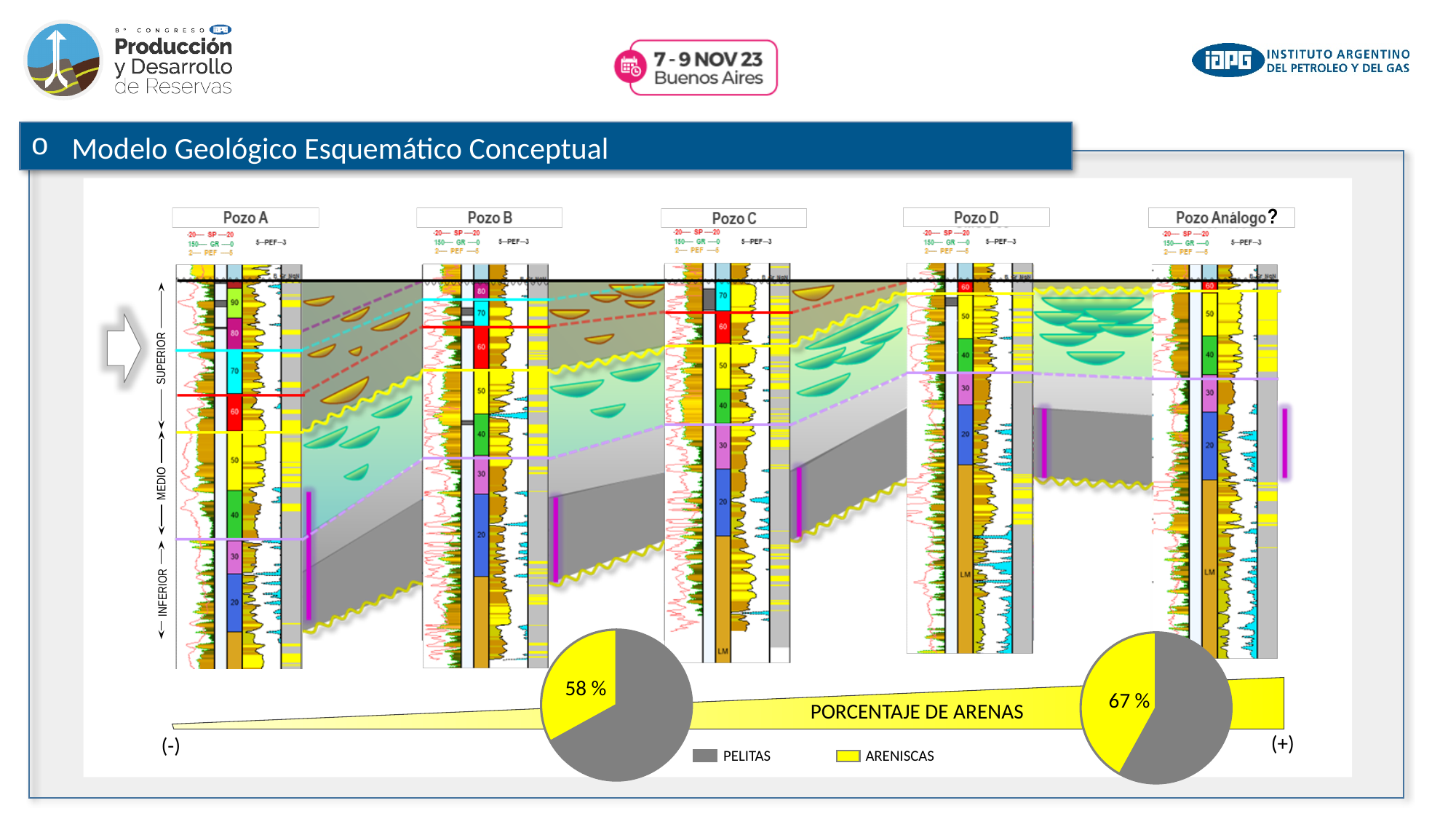
How many entries does the legend shared by the pie charts list? 2 What is the difference between the percentage labelled on the right pie chart and the one labelled on the left pie chart? 9 % Is the percentage labelled on the right pie chart greater or less than 70 %? less What percentage is labelled on the right pie chart? 67 % Which pie chart shows the higher labelled percentage, the left one or the right one? The right one What percentage is labelled on the left pie chart? 58 % Is the percentage labelled on the left pie chart greater or less than 50 %? greater How many pie charts are shown on the slide? 2 What kind of charts are the two charts at the bottom of the slide? Pie charts What are the two legend entries for the pie charts? PELITAS and ARENISCAS Which colour represents ARENISCAS in the pie charts? Yellow